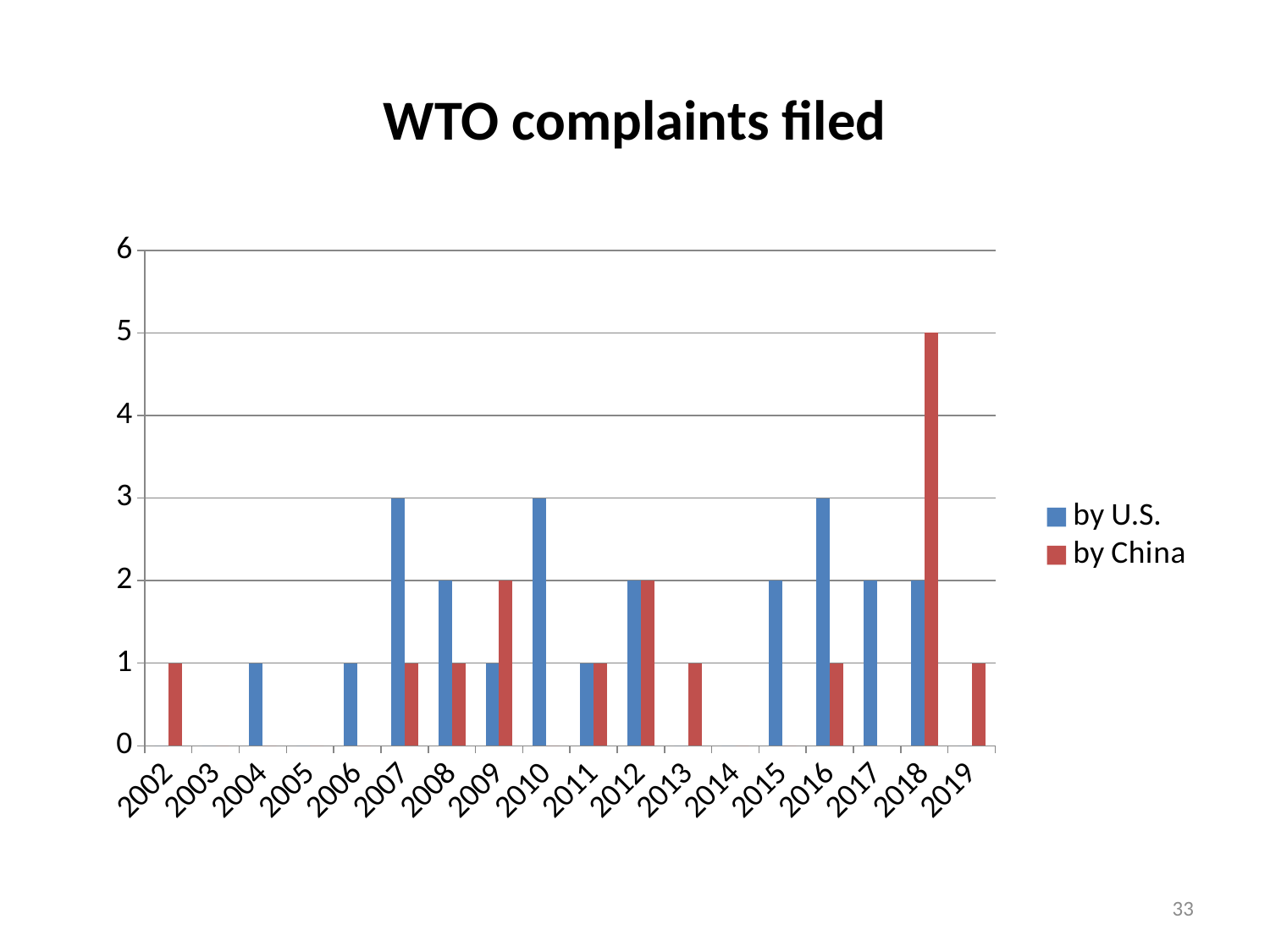
Is the value for China in 2018 greater or less than 4? greater How many series does the legend list? 2 How many WTO complaints were filed by the U.S. in 2017? 2 How many WTO complaints were filed by the U.S. in 2007? 3 What is the difference between the complaints filed by China and by the U.S. in 2018? 3 In 2016, which filed more WTO complaints, the U.S. or China? the U.S. What kind of chart is shown on the slide? bar chart How many years are shown on the x axis? 18 What is the title of the chart? WTO complaints filed In which year did China file the most WTO complaints? 2018 How many WTO complaints were filed by China in 2009? 2 How many WTO complaints were filed by China in 2018? 5